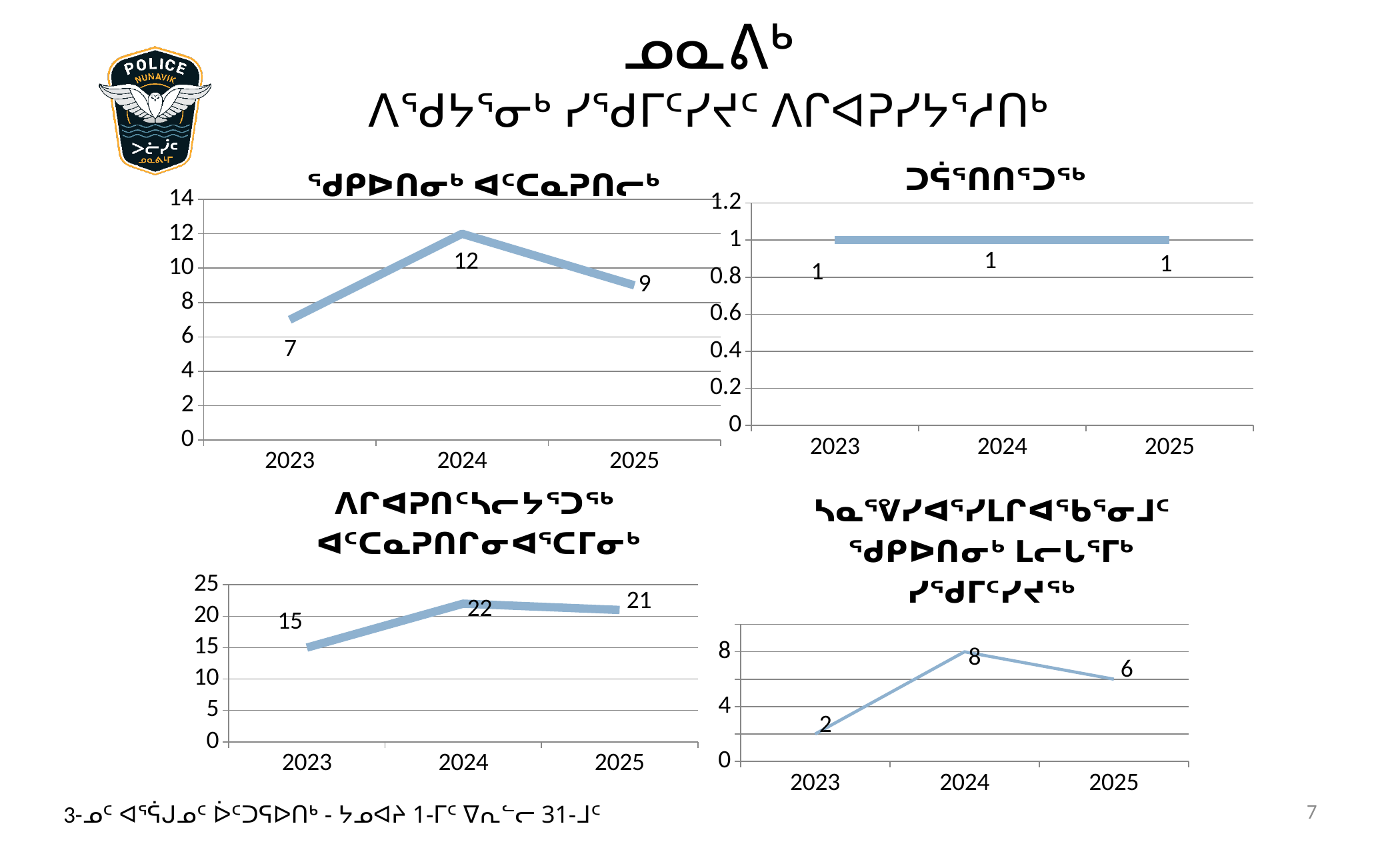
How many years are plotted in the bottom-right chart? 3 In the top-right chart, do the values rise, fall or stay flat from 2023 to 2025? stay flat In the bottom-left chart, what is the value for 2023? 15 In the bottom-right chart, which is larger, the value for 2023 or the value for 2025? 2025 What kind of chart is the top-left chart? line chart In the top-left chart, what is the value for 2024? 12 In the top-left chart, what is the difference between the 2024 and 2025 values? 3 In the top-right chart, what is the value for 2025? 1 In the bottom-right chart, what is the value for 2024? 8 In the top-left chart, which year has the lowest value? 2023 In the bottom-left chart, which year has the highest value? 2024 In the bottom-left chart, what is the difference between the 2024 and 2023 values? 7